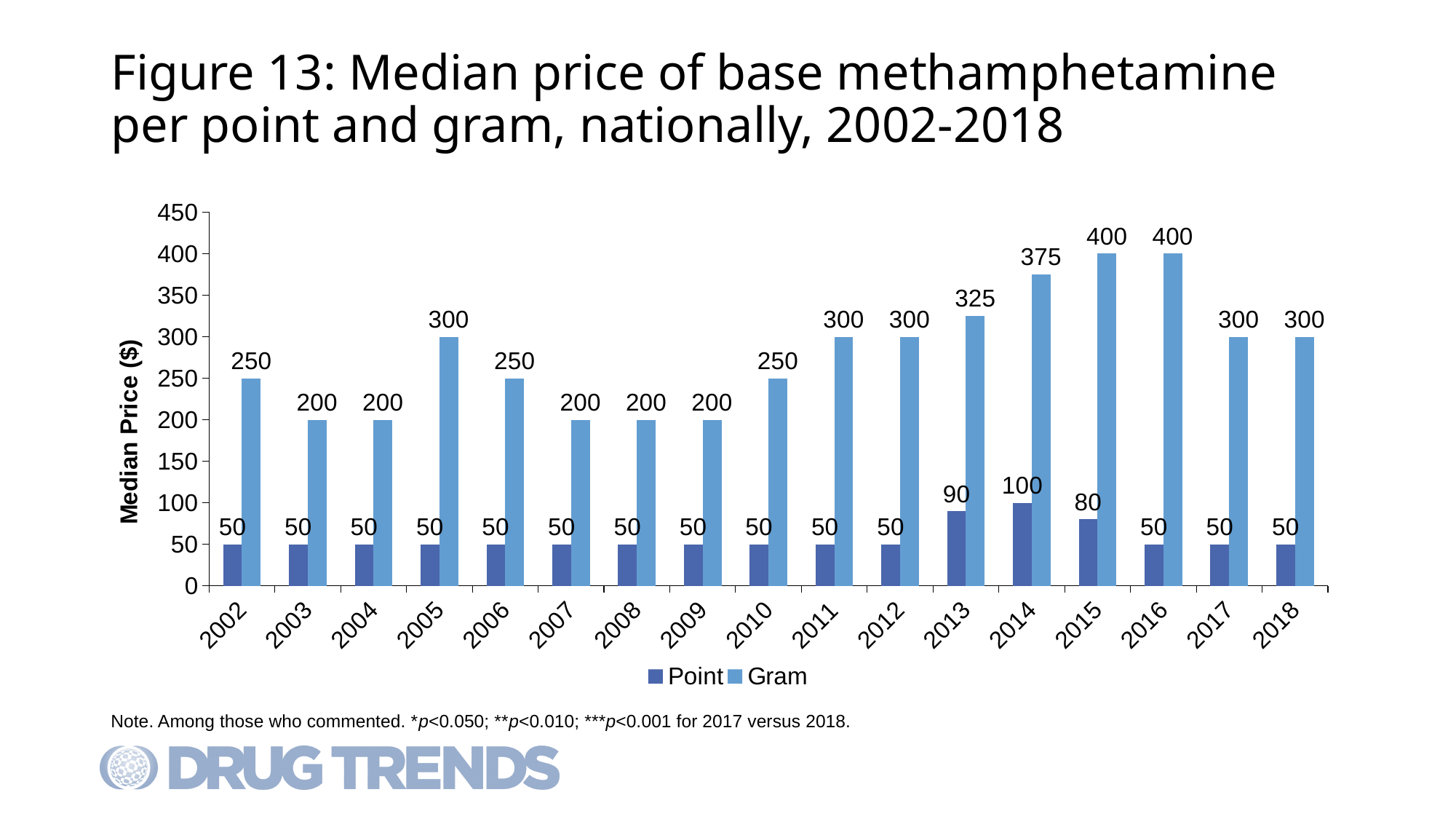
What is the median price per gram in 2014? 375 Which is larger, the median price per gram in 2013 or in 2012? 2013 How many series does the legend list? 2 What is the median price per point in 2013? 90 What is the label of the y axis? Median Price ($) What is the lowest median price per gram shown on the chart? 200 What kind of chart is shown on the slide? Bar chart In which year is the median price per point highest? 2014 Does the median price per gram rise or fall from 2014 to 2015? Rise What is the median price per gram in 2002? 250 What is the difference between the median price per gram in 2016 and in 2017? 100 How many years are shown on the x axis? 17